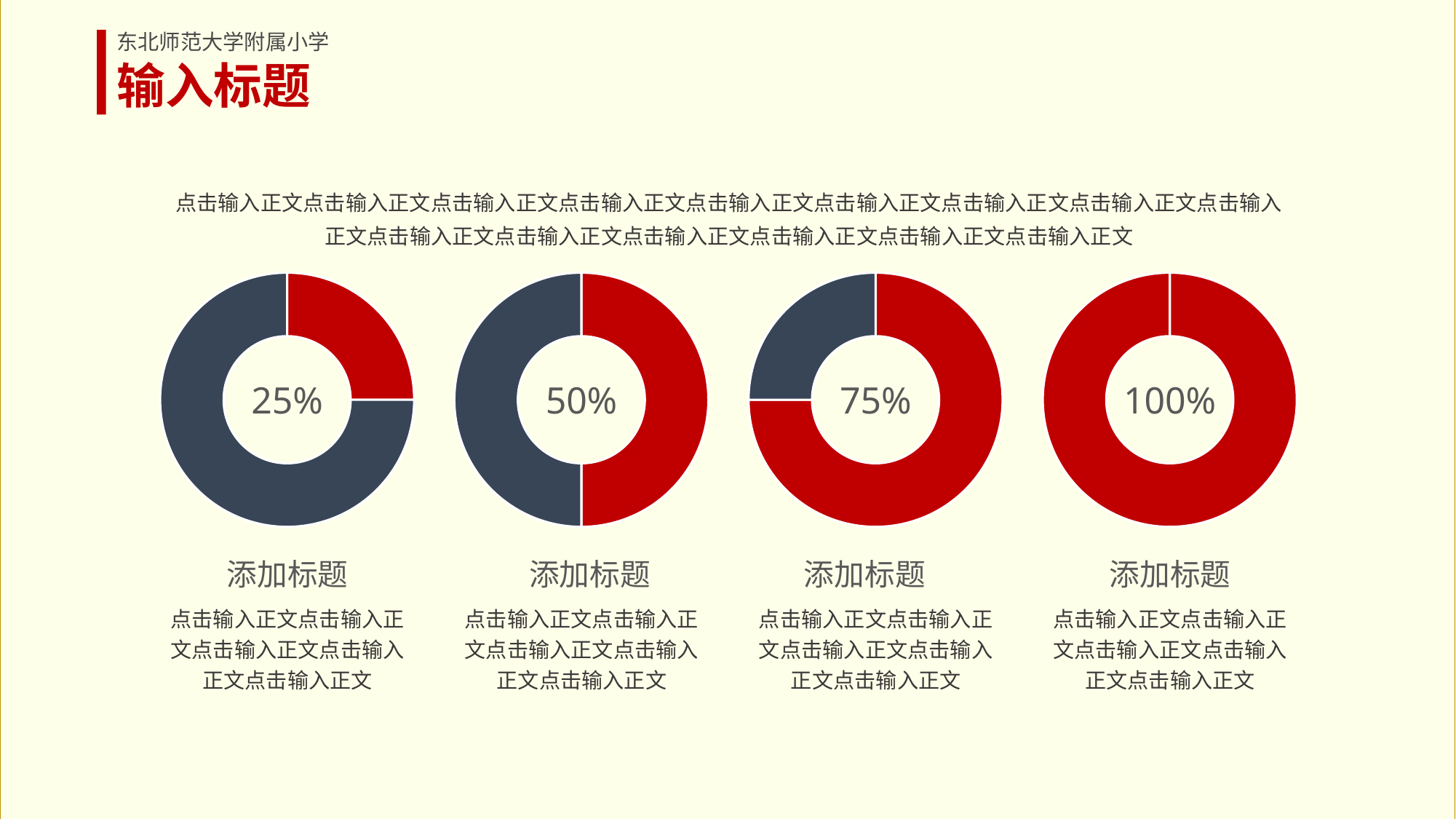
What percentage is shown in the centre of the second donut chart from the left? 50% What kind of chart is used for each of the four charts on the slide? Donut chart What percentage is shown in the centre of the third donut chart from the left? 75% What percentage is shown in the centre of the leftmost donut chart? 25% Which donut chart shows the lowest percentage? The leftmost one (25%) Which donut chart shows the highest percentage? The rightmost one (100%) What percentage is shown in the centre of the rightmost donut chart? 100% Which is larger, the percentage in the second donut chart or the percentage in the third donut chart? The third donut chart (75%) How many donut charts are on the slide? 4 What two colours are used for the segments of the donut charts? Red and dark grey-blue In the leftmost donut chart, what share of the ring is filled in red? 25% What is the difference between the percentage in the third donut chart and the percentage in the first donut chart? 50%